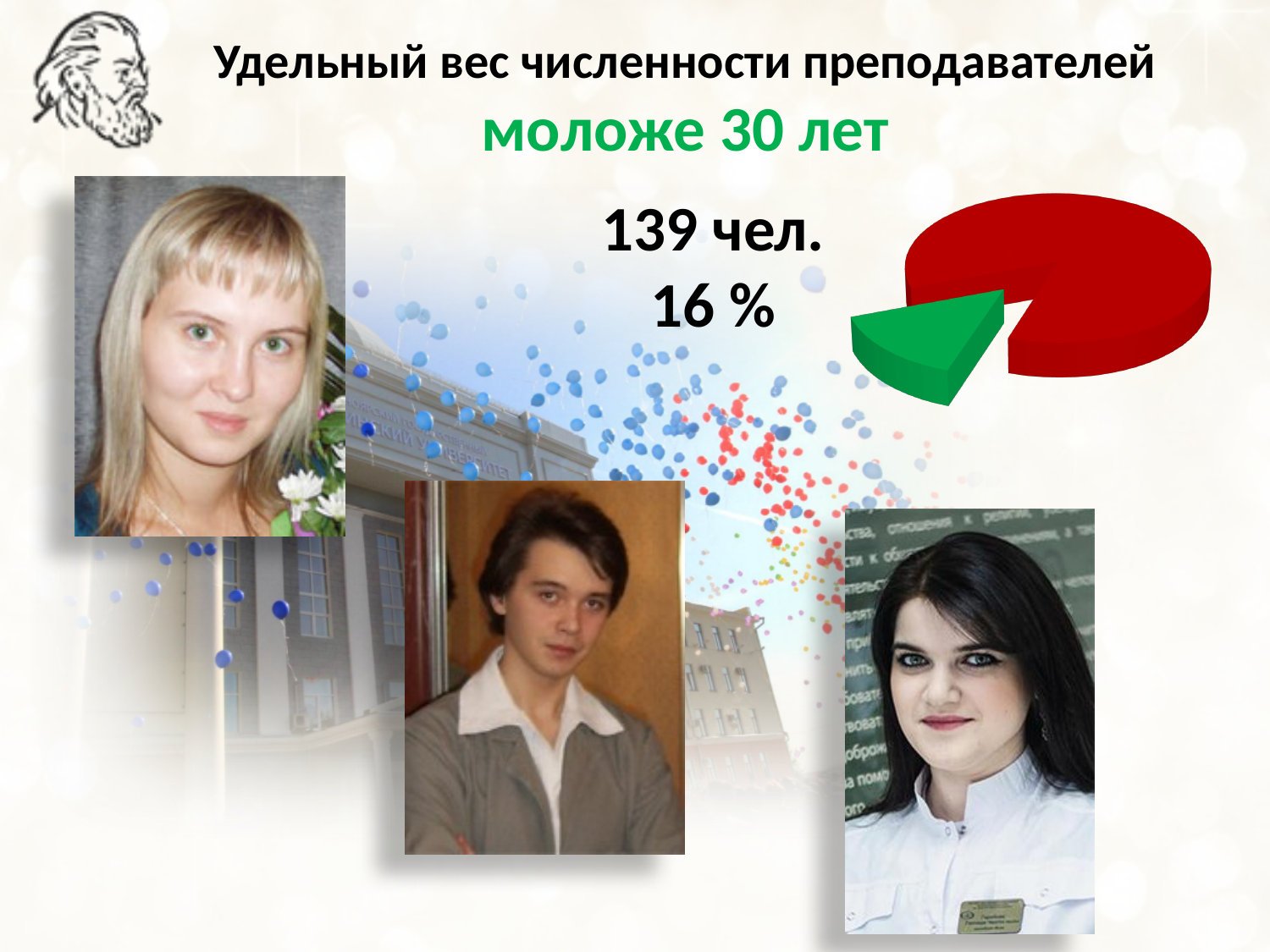
What share of the pie does the green slice (teachers under 30) represent? 16 % How many slices does the pie chart have? 2 What kind of chart is shown on the slide? pie chart Which slice of the pie chart is larger, the red one or the green one? the red one Which slice is pulled out (exploded) from the pie chart? the green slice How many teachers under 30 does the slide report? 139 чел. What is the title of the slide containing the pie chart? Удельный вес численности преподавателей моложе 30 лет What share of the pie does the red slice represent, given the green slice is 16 %? 84 %